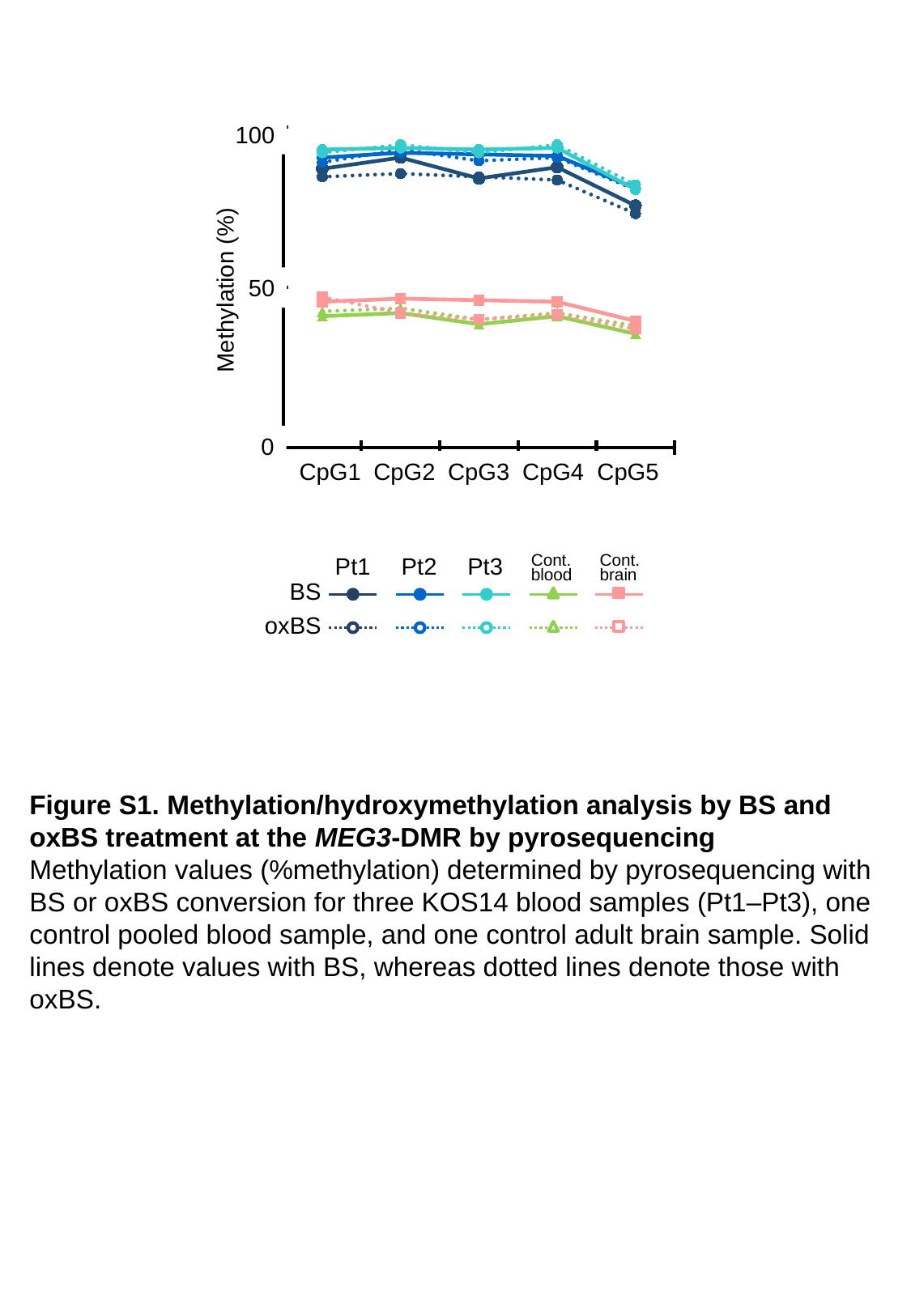
Is the BS value for Cont. blood at CpG3 greater or less than 50? less At CpG1, which is larger: the BS value for Pt3 or the BS value for Cont. blood? Pt3 What is the label of the y axis? Methylation (%) Is the BS value for Pt1 at CpG5 greater or less than 50? greater According to the legend, do solid lines represent BS or oxBS values? BS Overall, do the BS values for Pt2 rise or fall from CpG1 to CpG5? fall How many series does the legend list in total (all samples for both BS and oxBS)? 10 What kind of chart is shown on the slide? line chart Does the BS value for Pt1 rise or fall from CpG4 to CpG5? fall How many CpG sites are plotted along the x axis? 5 Is the BS value for Pt3 at CpG1 greater or less than 50? greater